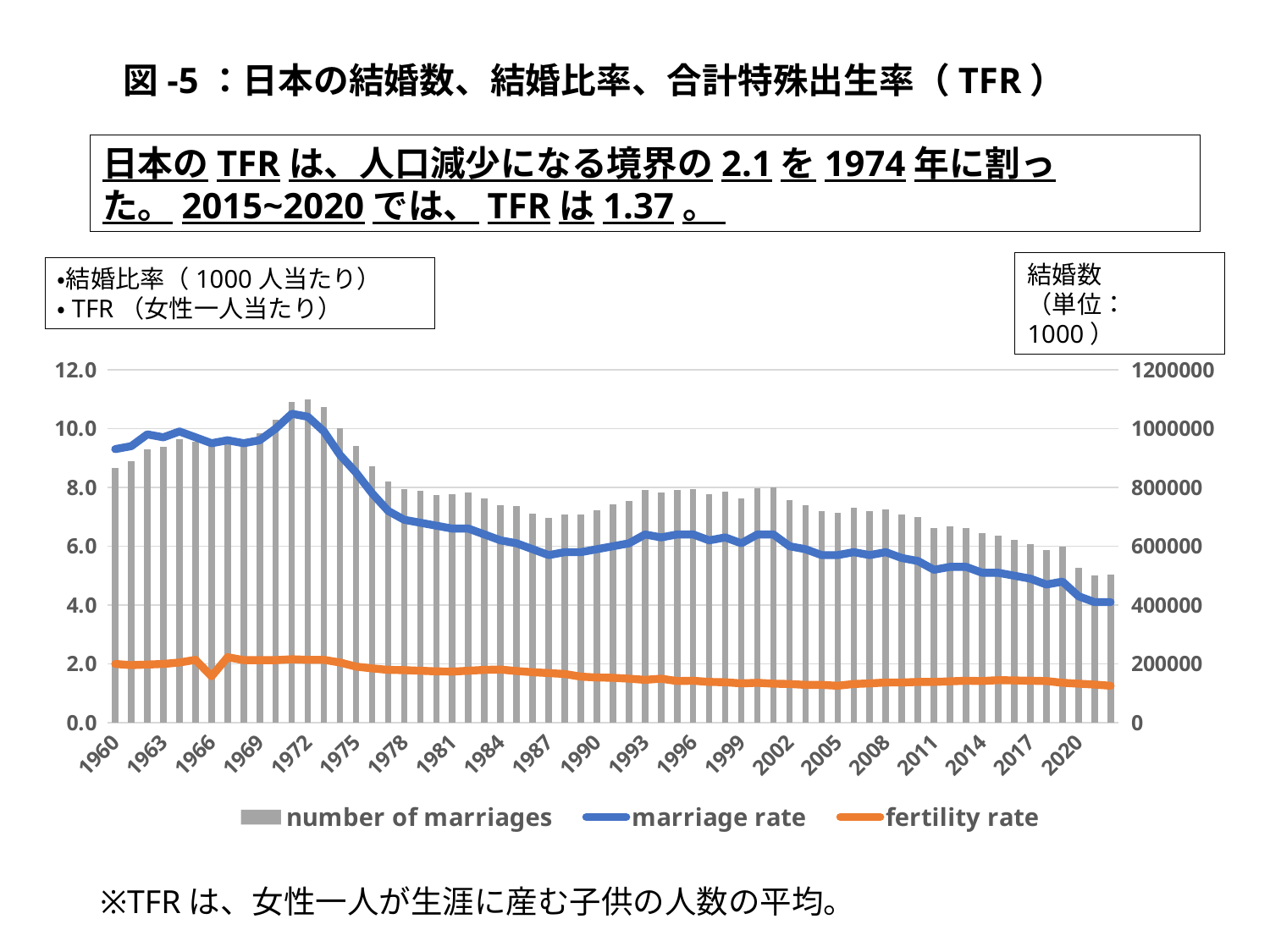
Is the number of marriages in 2020 greater or less than 600000? less Which year has the larger number of marriages, 1972 or 2020? 1972 Does the marriage rate generally rise or fall from 1972 to 2020? fall What kind of chart is shown on the slide? Combined bar and line chart Which series is plotted as bars in the chart? number of marriages What is the maximum value shown on the right-hand vertical axis? 1200000 How many series does the chart legend list? 3 Is the fertility rate in 2020 greater or less than 2.0? less In 1990, which is larger: the marriage rate or the fertility rate? marriage rate Is the marriage rate in 2020 greater or less than 6.0? less